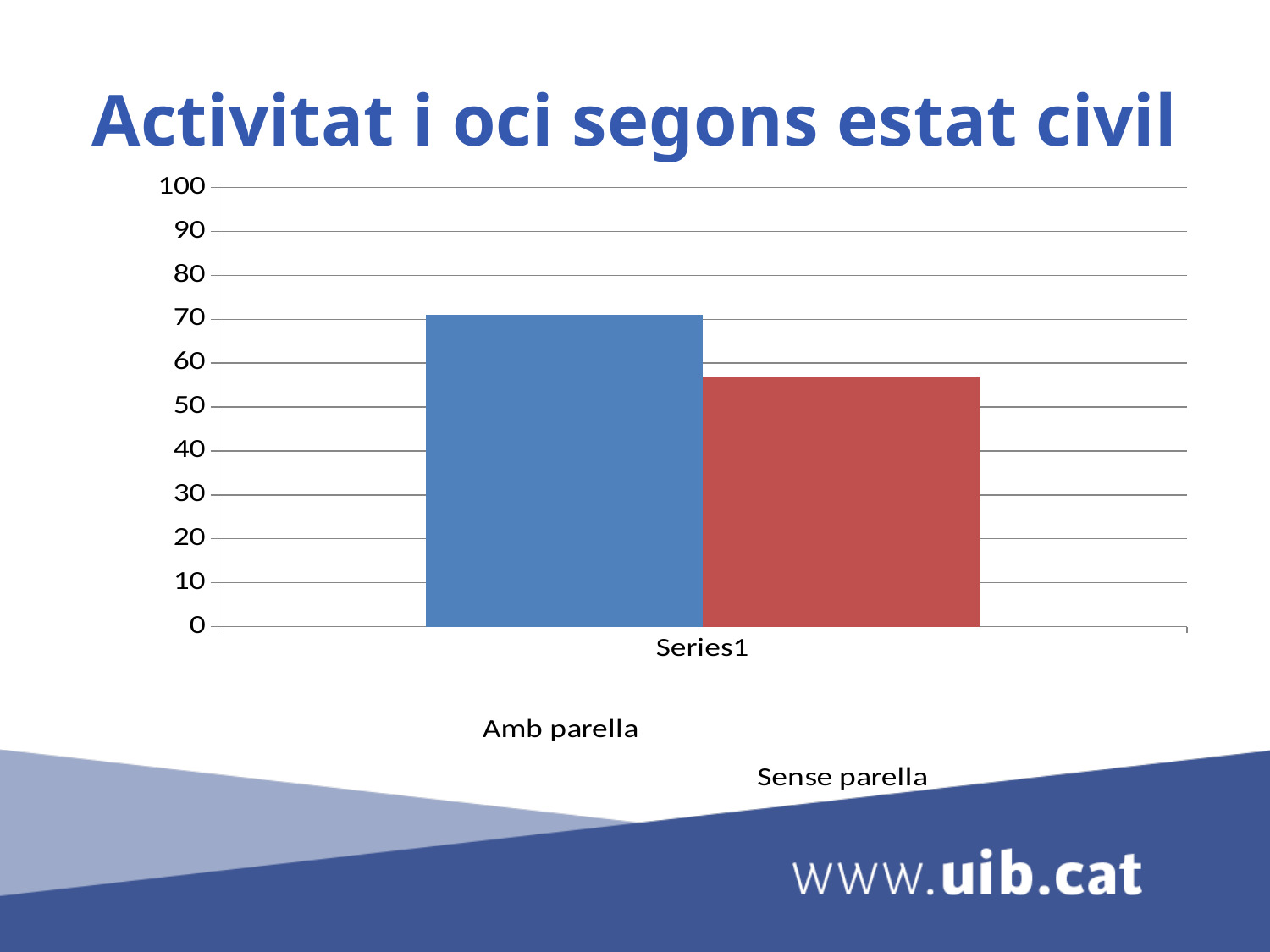
How many bars are plotted in the chart? 2 What colour is the bar for Sense parella? red What is the title of the slide's chart? Activitat i oci segons estat civil Is the value for Amb parella greater or less than 60? greater What type of chart is shown on the slide? bar chart Which series has the lowest bar? Sense parella Is the value for Sense parella greater or less than 60? less Is the value for Sense parella greater or less than 50? greater How many series does the legend list? 2 Which series has the highest bar? Amb parella Which is larger, the value for Amb parella or the value for Sense parella? Amb parella